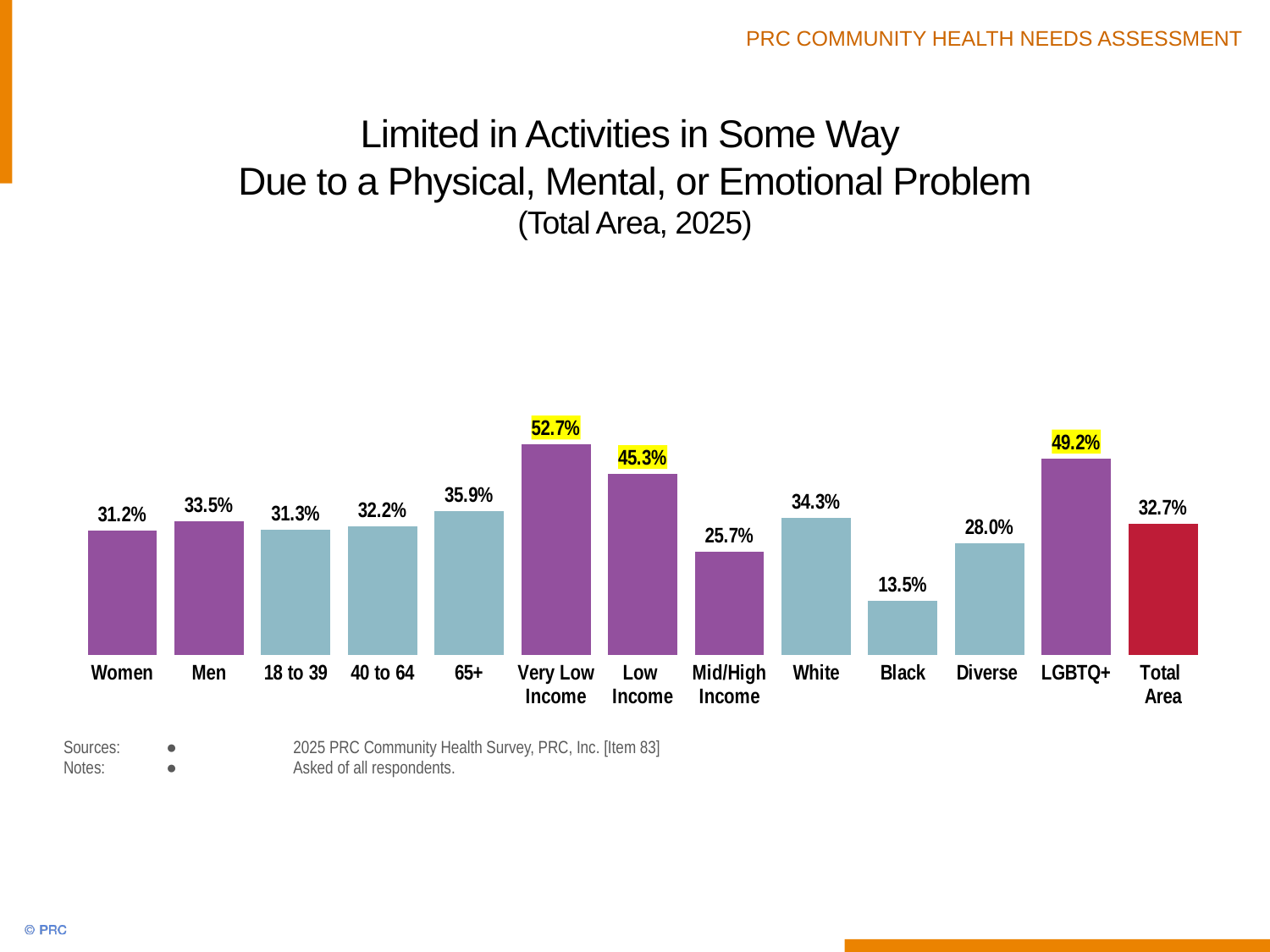
What kind of chart is shown on the slide? Bar chart What is the difference between the values for Very Low Income and Mid/High Income? 27.0% Which is larger, the value for Men or the value for Women? Men What is the value for Very Low Income? 52.7% How many categories are shown on the chart? 13 Which category has the lowest value? Black What is the value for 65+? 35.9% What is the value for Total Area? 32.7% What is the value for Black? 13.5% Which category has the highest value? Very Low Income What is the difference between the values for LGBTQ+ and Total Area? 16.5%